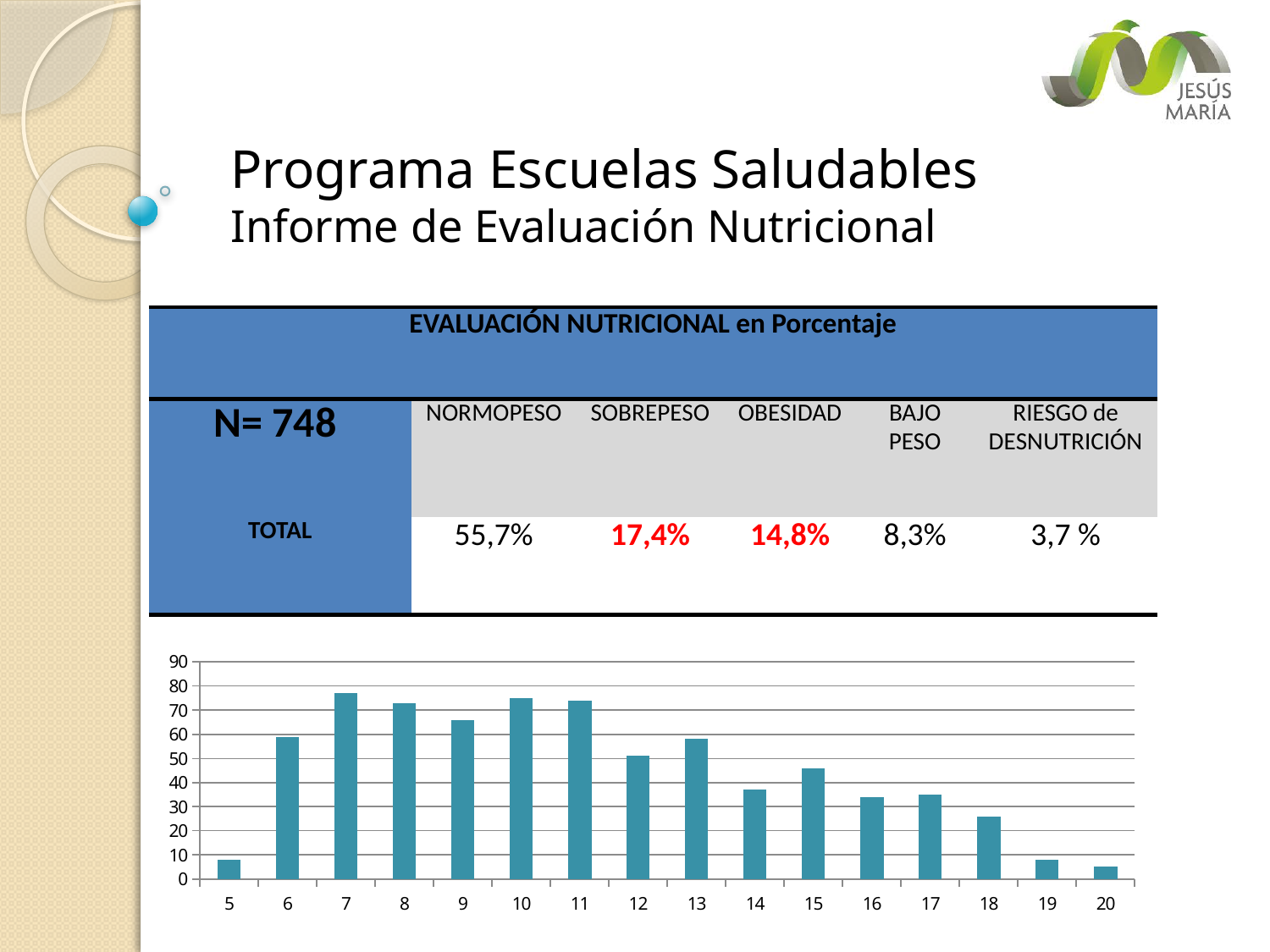
Is the value for category 15 greater or less than 40? greater What kind of chart is shown at the bottom of the slide? bar chart Is the value for category 8 greater or less than 70? greater Which has the larger value, category 14 or category 15? 15 Which category has the lowest bar in the chart? 20 Do the bar values generally rise or fall from category 13 to category 20? fall How many categories are shown on the x axis of the bar chart? 16 Is the value for category 6 greater or less than 50? greater Which has the larger value, category 7 or category 12? 7 What is the highest value shown on the y axis of the chart? 90